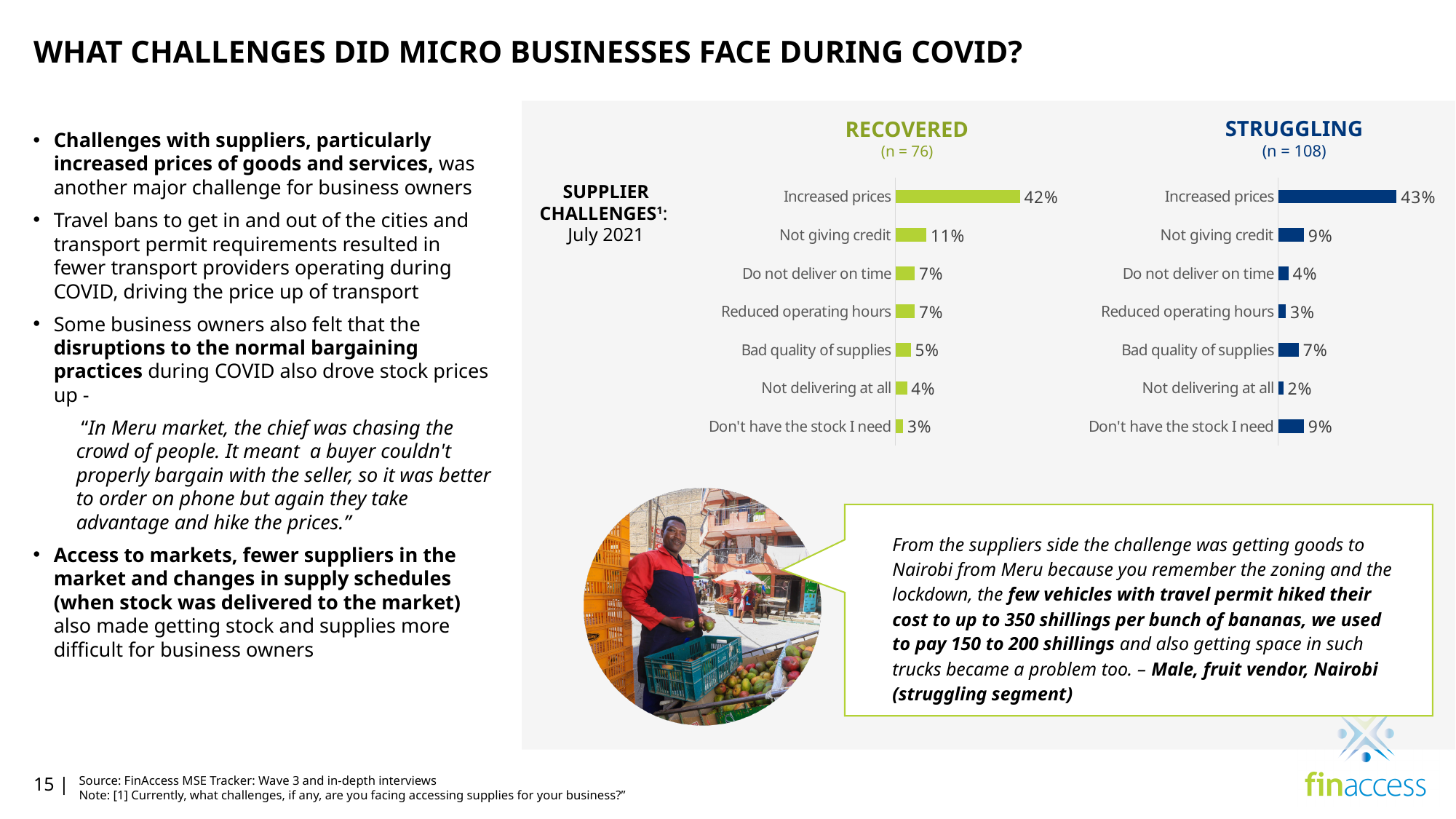
What kind of chart is the STRUGGLING chart? Bar chart In the RECOVERED chart, what is the value for Increased prices? 42% How many categories does the RECOVERED chart show? 7 In the RECOVERED chart, what is the difference between Increased prices and Not giving credit? 31% In the RECOVERED chart, which category has the lowest value? Don't have the stock I need In the STRUGGLING chart, what is the value for Don't have the stock I need? 9% In the STRUGGLING chart, which category has the lowest value? Not delivering at all What is the sample size (n) shown for the STRUGGLING chart? 108 In the RECOVERED chart, which category has the highest value? Increased prices What is the difference between the Increased prices values in the STRUGGLING chart and the RECOVERED chart? 1% Which is larger: Bad quality of supplies in the RECOVERED chart or in the STRUGGLING chart? STRUGGLING In the STRUGGLING chart, what is the value for Not giving credit? 9%